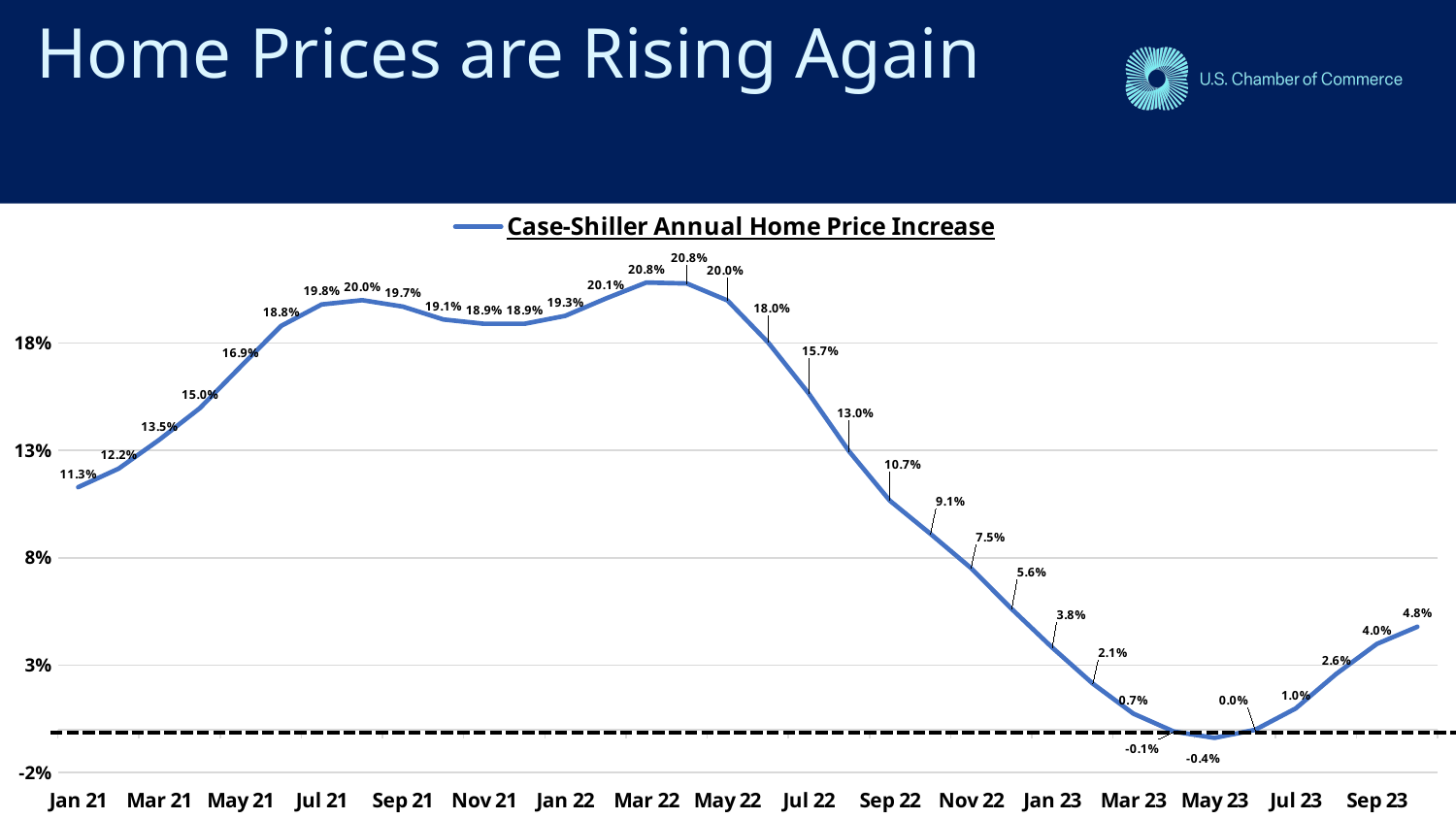
What is the Case-Shiller annual home price increase for Mar 22? 20.8% Does the line rise or fall between Jul 22 and Jan 23? Fall What is the lowest value plotted on the chart? -0.4% What is the Case-Shiller annual home price increase for Jan 21? 11.3% What series name does the legend show? Case-Shiller Annual Home Price Increase What is the highest value plotted on the chart? 20.8% Is the value for Nov 22 greater or less than 8%? less Which is larger, the value for Jul 22 or the value for Sep 22? Jul 22 What type of chart is shown on the slide? Line chart What is the Case-Shiller annual home price increase for Jan 23? 3.8% What is the Case-Shiller annual home price increase for May 23? -0.4% What is the difference between the values for Jan 21 and Jan 23? 7.5%